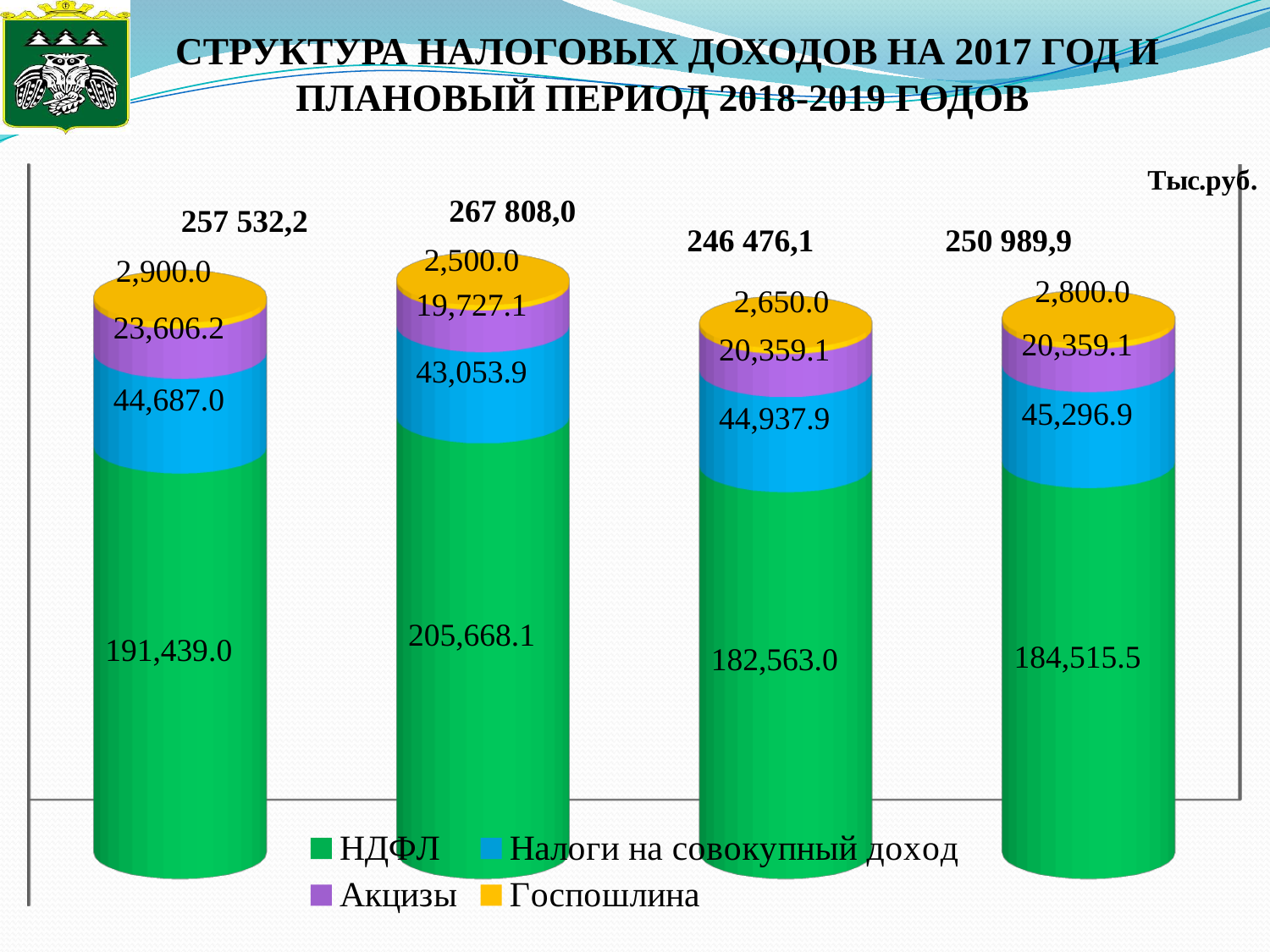
What is the difference between the Госпошлина value in the first bar and the Госпошлина value in the second bar? 400.0 How many series does the legend list? 4 What is the difference between the НДФЛ value in the second bar and the НДФЛ value in the first bar? 14,229.1 Which is larger: the Акцизы value in the first bar or the Акцизы value in the second bar? The first bar (23,606.2) What is the value of Налоги на совокупный доход in the fourth bar from the left? 45,296.9 What unit of measurement is indicated on the chart? Тыс.руб. What is the value of Госпошлина in the first bar from the left? 2,900.0 Which bar has the highest total value? The second bar from the left (267 808,0) What is the value of Акцизы in the third bar from the left? 20,359.1 Which bar has the lowest total value? The third bar from the left (246 476,1) What is the value of НДФЛ in the second bar from the left? 205,668.1 What is the total printed above the third bar from the left? 246 476,1